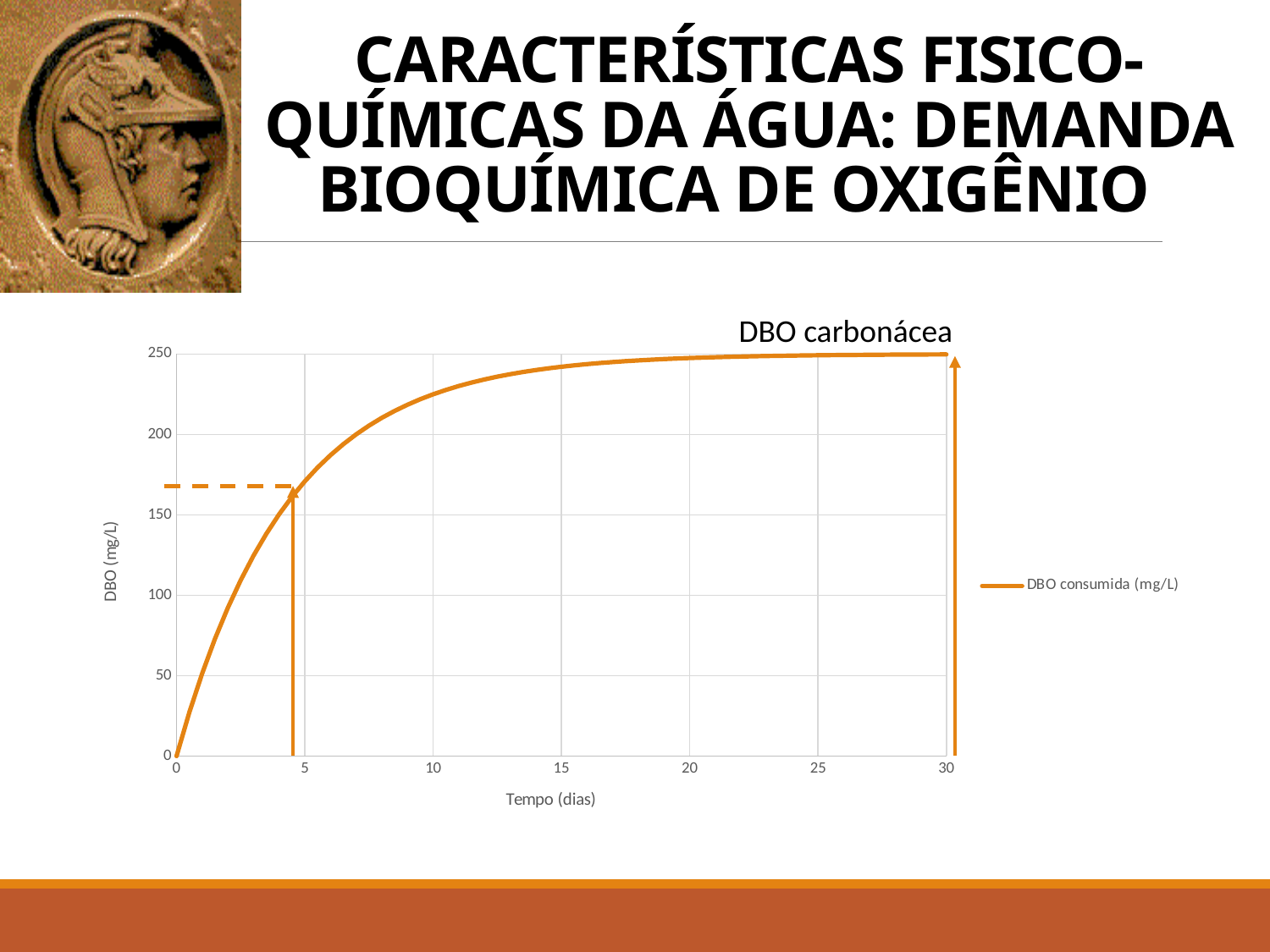
What is the title of the chart? DBO carbonácea Does the DBO consumida value rise or fall as Tempo (dias) increases? rise Is the value of DBO consumida at 3 dias greater or less than 150? less Is the value of DBO consumida at 5 dias greater or less than 150? greater Is the value of DBO consumida at 5 dias greater or less than 200? less Which is larger, the DBO consumida value at 5 dias or at 25 dias? 25 dias How many series does the chart legend list? 1 What kind of chart is shown on the slide? line chart What is the name of the series shown in the legend? DBO consumida (mg/L)